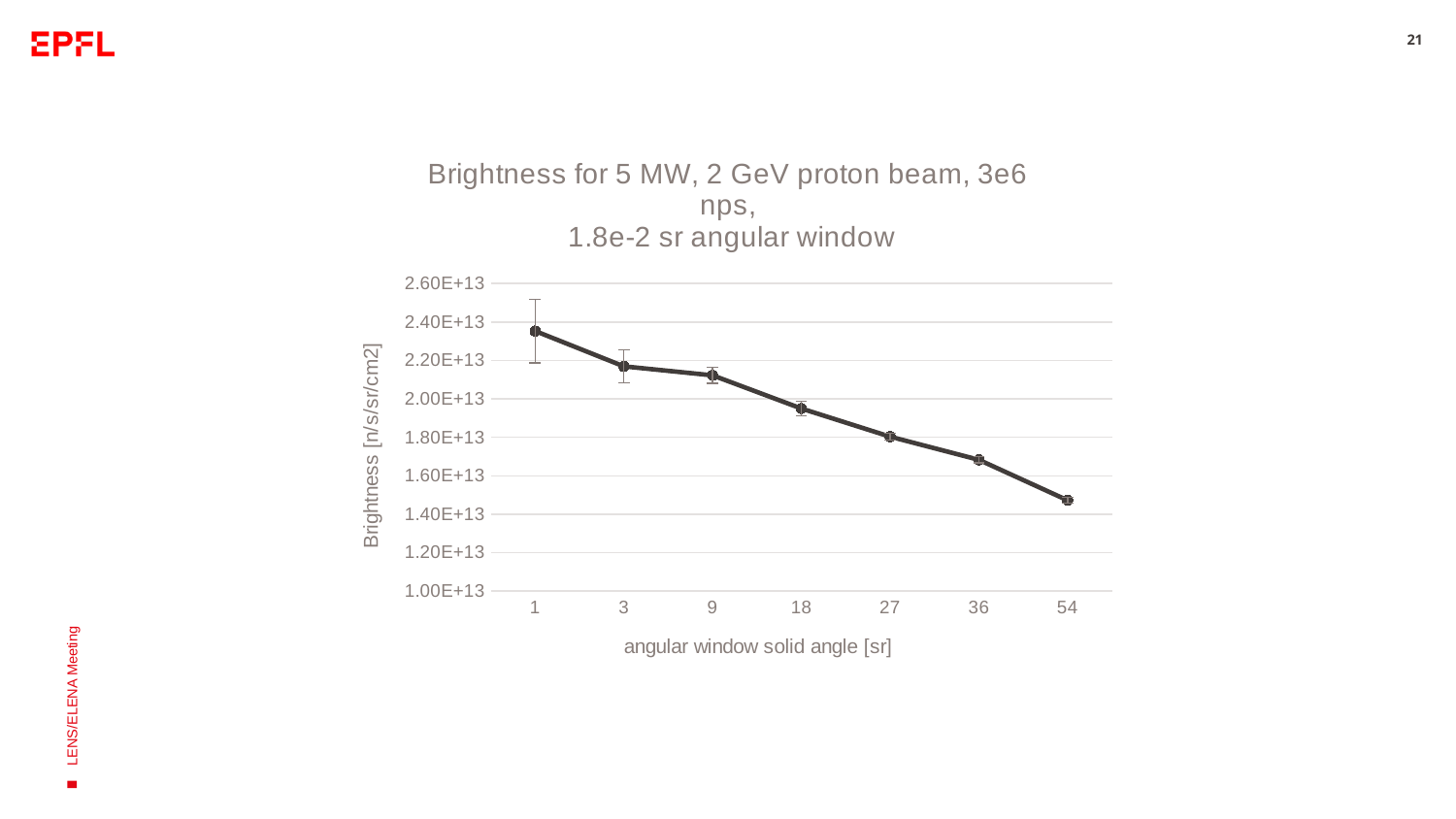
Is the brightness value for solid angle 1 greater or less than 2.20E+13? greater What is the label of the x axis? angular window solid angle [sr] What kind of chart is shown on the slide? line chart How many data points are plotted along the x axis? 7 What is the label of the y axis? Brightness [n/s/sr/cm2] Is the brightness value for solid angle 54 greater or less than 1.60E+13? less Is the brightness value for solid angle 9 greater or less than 2.00E+13? greater At which angular window solid angle is the brightness lowest? 54 Which has the larger brightness: solid angle 18 or solid angle 36? 18 Which has the larger brightness: solid angle 1 or solid angle 54? 1 Do the brightness values rise or fall as the angular window solid angle increases along the x axis? fall At which angular window solid angle is the brightness highest? 1